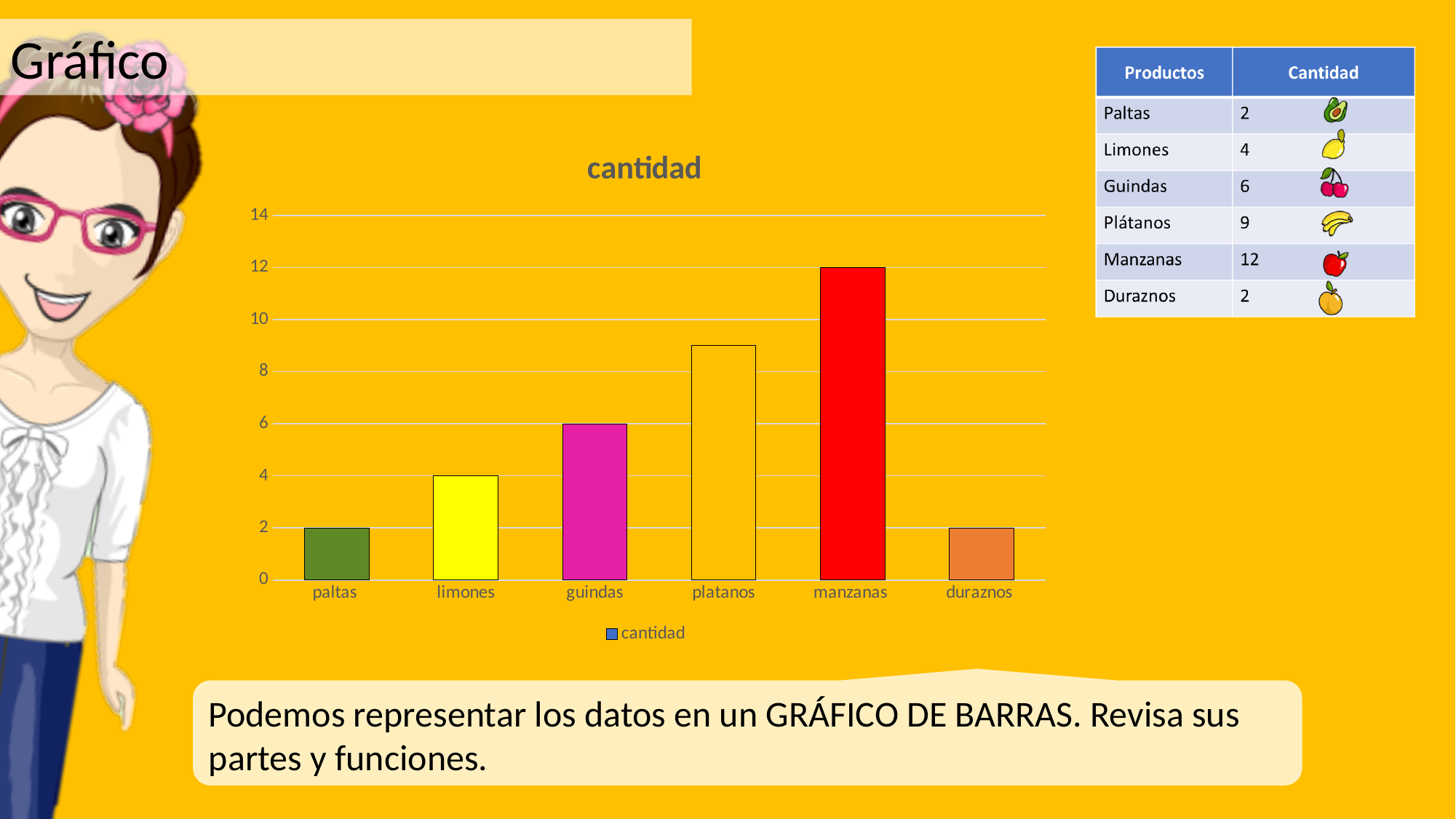
What is the value for paltas? 2 Which is larger, the value for limones or the value for duraznos? limones What is the value for manzanas? 12 What kind of chart is this? bar chart What is the title of the chart? cantidad Is the value for platanos greater or less than 8? greater Which category has the highest value? manzanas What is the value for guindas? 6 What is the value for limones? 4 What is the difference between the values for manzanas and guindas? 6 How many series does the legend list? 1 How many categories are shown on the x axis? 6